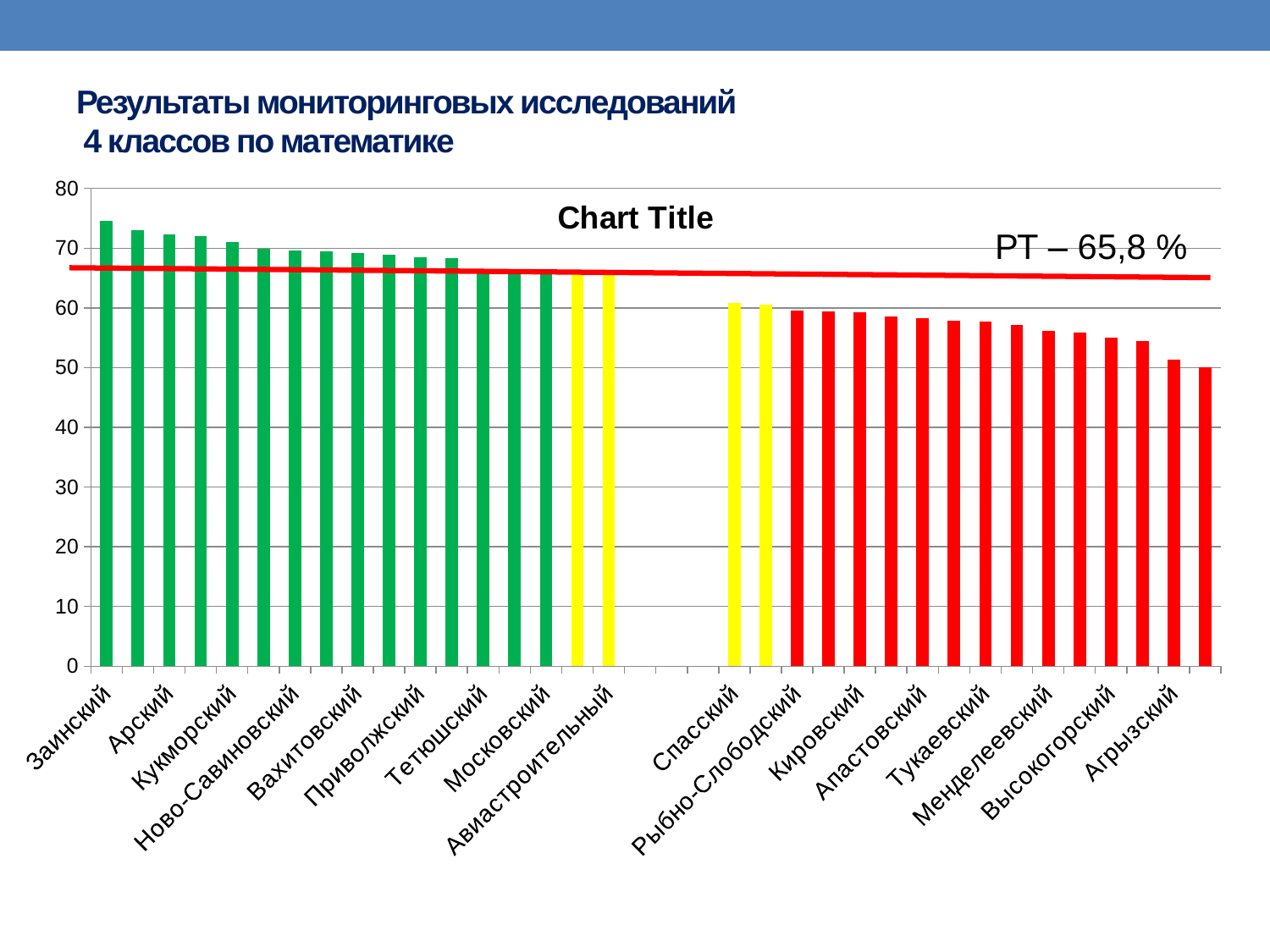
Is the value for Заинский greater or less than 70? greater Is the value for Менделеевский greater or less than 60? less Is the value for Агрызский greater or less than 60? less What is the title shown inside the chart area? Chart Title Which category has the highest value? Заинский What kind of chart is shown on the slide? bar chart Which is larger, the value for Заинский or the value for Агрызский? Заинский Which is larger, the value for Арский or the value for Менделеевский? Арский What value is written next to the red horizontal line on the chart? РТ – 65,8 % Do the bar values rise or fall from left to right along the x axis? fall